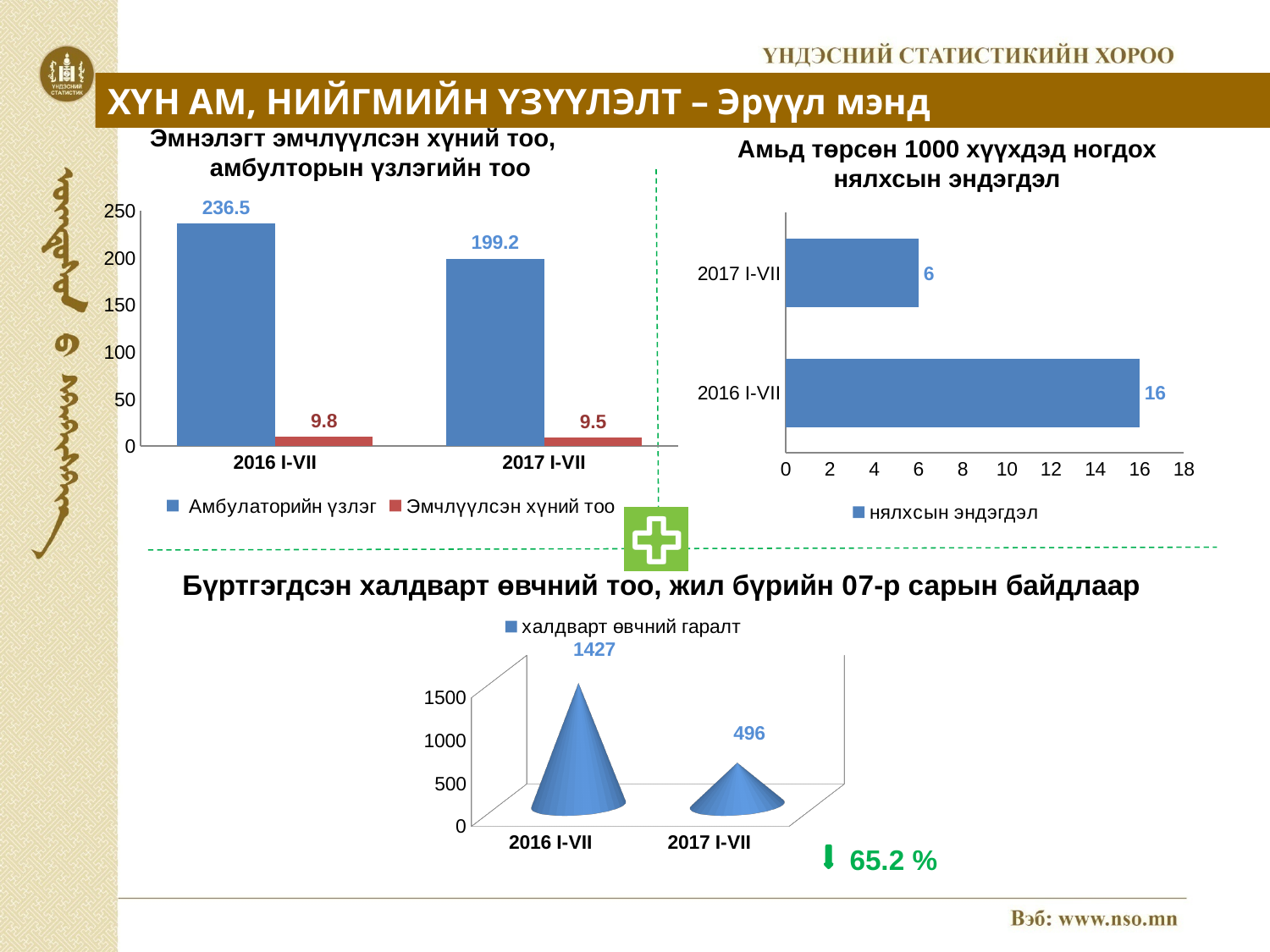
In the top-left chart 'Эмнэлэгт эмчлүүлсэн хүний тоо, амбулторын үзлэгийн тоо', does Амбулаторийн үзлэг rise or fall from 2016 I-VII to 2017 I-VII? fall In the top-right chart 'Амьд төрсөн 1000 хүүхдэд ногдох нялхсын эндэгдэл', what is the difference between the 2016 I-VII and 2017 I-VII values? 10 In the bottom chart 'Бүртгэгдсэн халдварт өвчний тоо, жил бүрийн 07-р сарын байдлаар', which period has the lowest value? 2017 I-VII In the bottom chart 'Бүртгэгдсэн халдварт өвчний тоо, жил бүрийн 07-р сарын байдлаар', what is the value for 2016 I-VII? 1427 In the top-left chart 'Эмнэлэгт эмчлүүлсэн хүний тоо, амбулторын үзлэгийн тоо', by how much did Амбулаторийн үзлэг fall from 2016 I-VII to 2017 I-VII? 37.3 In the top-right chart 'Амьд төрсөн 1000 хүүхдэд ногдох нялхсын эндэгдэл', what is the value for 2017 I-VII? 6 In the top-left chart 'Эмнэлэгт эмчлүүлсэн хүний тоо, амбулторын үзлэгийн тоо', what is the value of Амбулаторийн үзлэг for 2016 I-VII? 236.5 In the bottom chart 'Бүртгэгдсэн халдварт өвчний тоо, жил бүрийн 07-р сарын байдлаар', what percentage change is annotated next to the chart? 65.2 % In the top-left chart 'Эмнэлэгт эмчлүүлсэн хүний тоо, амбулторын үзлэгийн тоо', how many series does the legend list? 2 In the top-right chart 'Амьд төрсөн 1000 хүүхдэд ногдох нялхсын эндэгдэл', what is the value for 2016 I-VII? 16 In the top-left chart 'Эмнэлэгт эмчлүүлсэн хүний тоо, амбулторын үзлэгийн тоо', what is the value of Эмчлүүлсэн хүний тоо for 2017 I-VII? 9.5 What kind of chart is the top-right chart 'Амьд төрсөн 1000 хүүхдэд ногдох нялхсын эндэгдэл'? bar chart